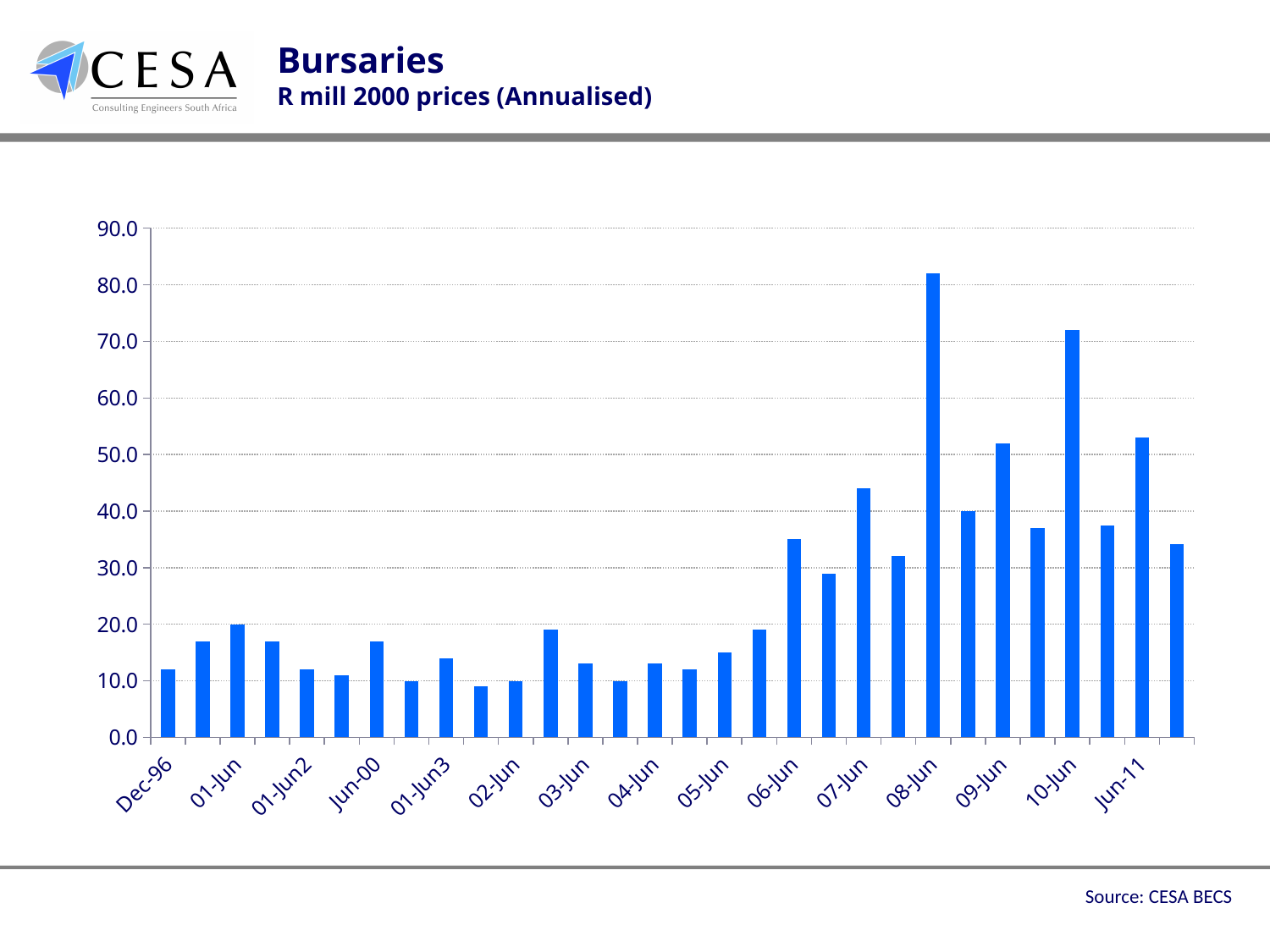
What kind of chart is shown on the slide? bar chart How many labels are shown on the x axis? 15 Is the value for 08-Jun greater or less than 70? greater Which x-axis label has the tallest bar? 08-Jun Which is larger, the value for Dec-96 or the value for 09-Jun? 09-Jun Is the value for 10-Jun greater or less than 60? greater Is the value for 07-Jun greater or less than 50? less Do the values generally rise or fall from left to right along the x axis? rise Which is larger, the value for 08-Jun or the value for 10-Jun? 08-Jun What is the title of the chart? Bursaries